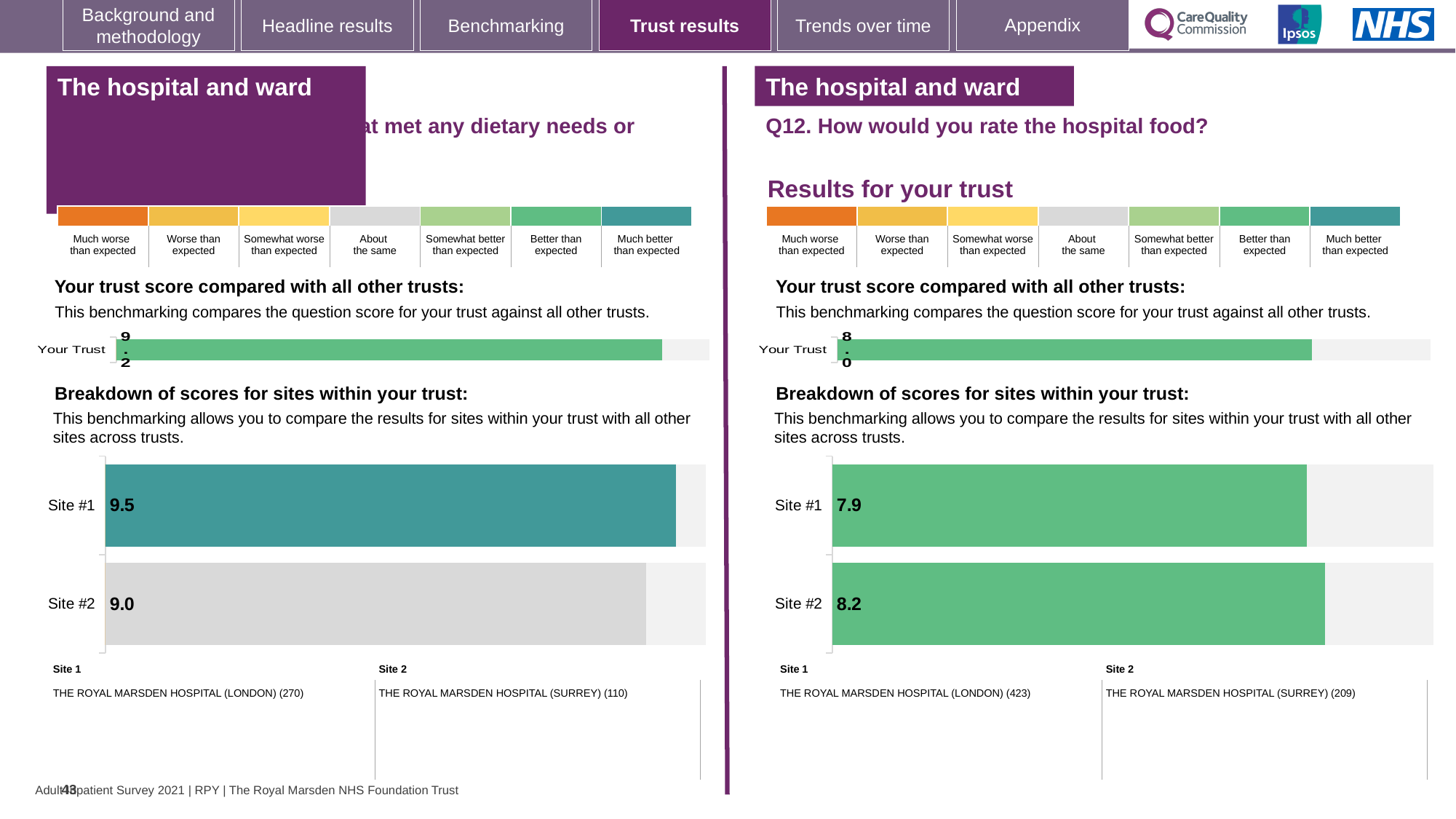
What type of chart is used for the site breakdown on the right-hand side of the slide? Bar chart On the right-hand chart for Q12 (hospital food), what is the score for Site #1? 7.9 On the left-hand site breakdown chart, which site has the lower score? Site #2 On the left-hand site breakdown chart, what is the score for Site #1? 9.5 How many sites are shown in the right-hand site breakdown chart for Q12? 2 On the left-hand 'Your trust score compared with all other trusts' chart, what is the score shown for Your Trust? 9.2 On the left-hand site breakdown chart, what is the score for Site #2? 9.0 On the left-hand site breakdown chart, what is the difference between the Site #1 and Site #2 scores? 0.5 On the right-hand site breakdown chart for Q12, which site has the higher score? Site #2 On the right-hand chart for Q12 (hospital food), what is the score for Site #2? 8.2 On the right-hand 'Your trust score compared with all other trusts' chart for Q12, what is the score shown for Your Trust? 8.0 On the right-hand site breakdown chart for Q12, what is the difference between the Site #2 and Site #1 scores? 0.3